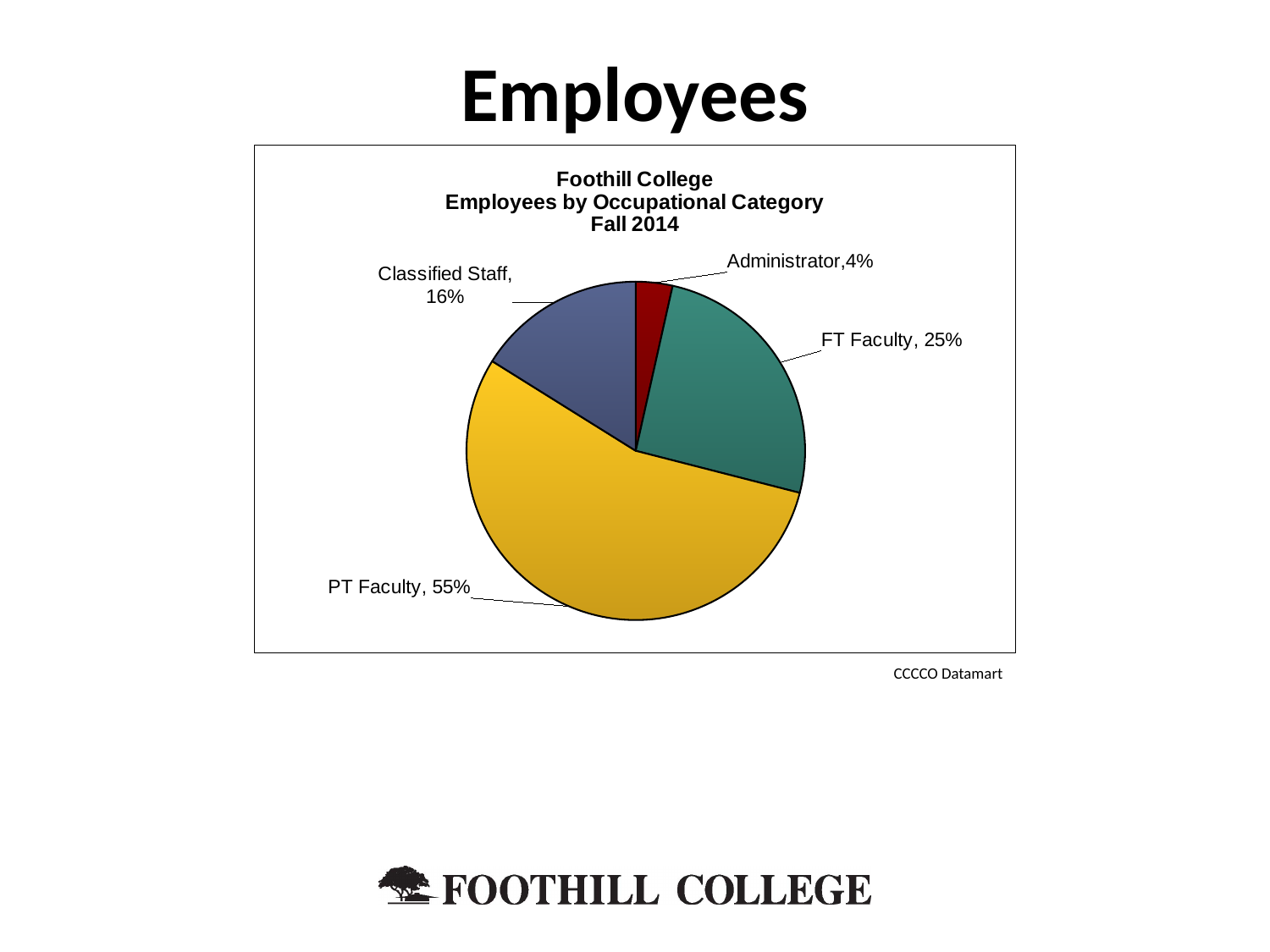
Which occupational category has the smallest share of employees? Administrator What kind of chart is shown on the slide? pie chart What is the difference in percentage points between PT Faculty and FT Faculty? 30 Which is larger, the share for Classified Staff or the share for FT Faculty? FT Faculty What is the combined share of FT Faculty and PT Faculty? 80% What share of employees are Classified Staff? 16% What share of employees are FT Faculty? 25% For which term is the employee data shown in the chart title? Fall 2014 What share of employees are PT Faculty? 55% What share of employees are Administrators? 4% Which occupational category has the largest share of employees? PT Faculty How many occupational categories are shown in the pie chart? 4